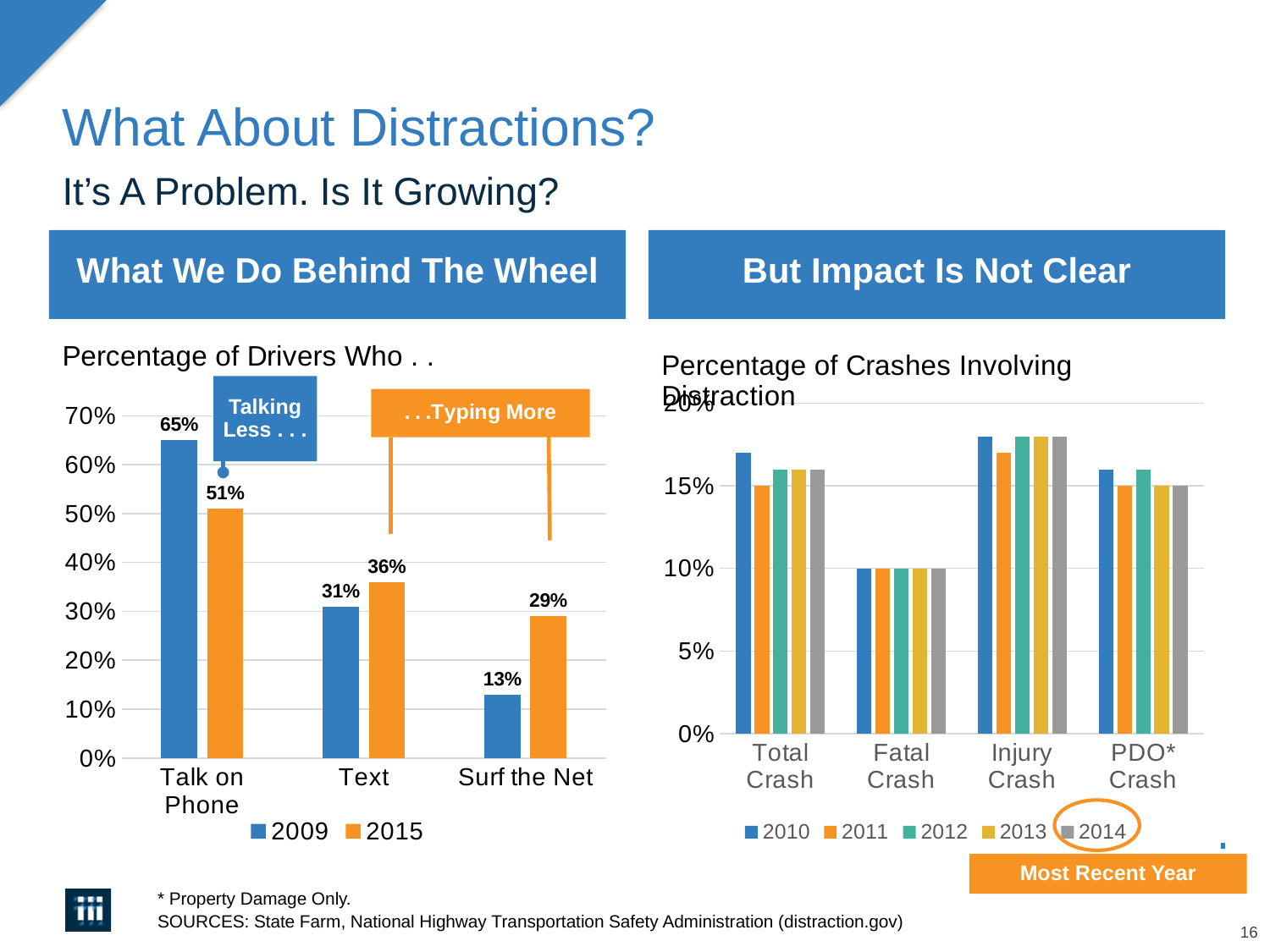
How many categories are shown on the x axis of the 'Percentage of Crashes Involving Distraction' chart? 4 In the 'Percentage of Drivers Who . .' chart, which category has the lowest 2009 value? Surf the Net How many series does the legend of the 'Percentage of Crashes Involving Distraction' chart list? 5 In the 'Percentage of Drivers Who . .' chart, which category has the highest 2015 value? Talk on Phone What kind of chart is the 'Percentage of Crashes Involving Distraction' chart? Bar chart In the 'Percentage of Drivers Who . .' chart, what is the difference between the 2015 and 2009 values for Surf the Net? 16% In the 'Percentage of Drivers Who . .' chart, what is the difference between the 2009 and 2015 values for Talk on Phone? 14% In the 'Percentage of Drivers Who . .' chart, which is larger for Text: the 2009 value or the 2015 value? 2015 In the 'Percentage of Drivers Who . .' chart, what is the 2015 value for Text? 36% In the 'Percentage of Drivers Who . .' chart, what is the 2009 value for Talk on Phone? 65% In the 'Percentage of Crashes Involving Distraction' chart, is the 2010 value for Injury Crash greater or less than 15%? greater In the 'Percentage of Drivers Who . .' chart, what is the 2015 value for Surf the Net? 29%